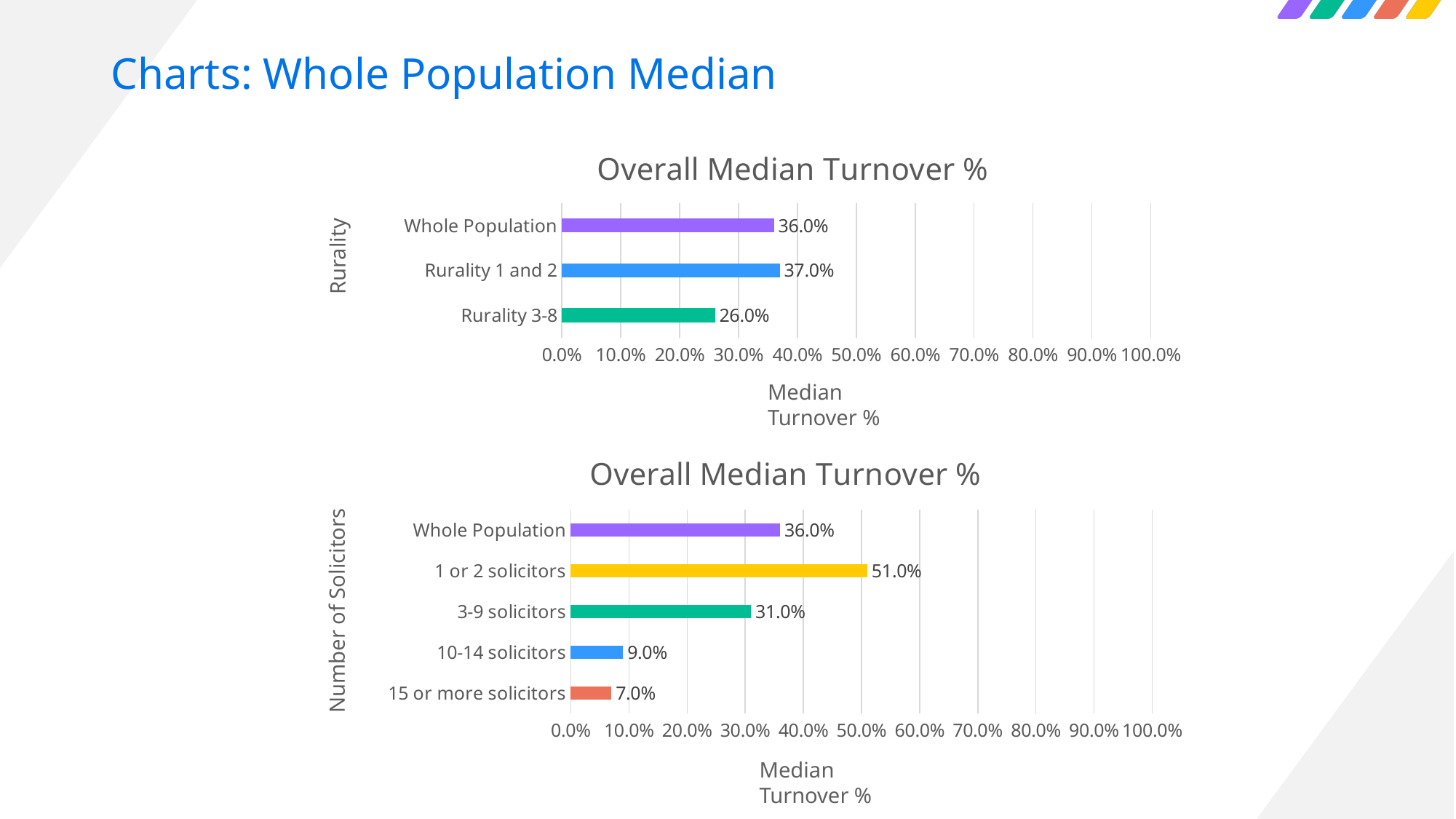
In the bottom chart (Number of Solicitors), which is larger: the value for 3-9 solicitors or the value for 10-14 solicitors? 3-9 solicitors In the top chart (Rurality), how many categories are plotted? 3 What type of chart is the bottom chart (Number of Solicitors)? Bar chart In the bottom chart (Number of Solicitors), what is the difference between the values for 1 or 2 solicitors and Whole Population? 15.0% In the top chart (Rurality), what is the difference between the values for Rurality 1 and 2 and Rurality 3-8? 11.0% In the bottom chart (Number of Solicitors), how many categories are plotted? 5 In the bottom chart (Number of Solicitors), which category has the highest median turnover %? 1 or 2 solicitors In the top chart (Rurality), which category has the lowest median turnover %? Rurality 3-8 In the bottom chart (Number of Solicitors), what is the median turnover % for 1 or 2 solicitors? 51.0% In the top chart (Rurality), what is the median turnover % for Rurality 1 and 2? 37.0% In the bottom chart (Number of Solicitors), what is the median turnover % for 15 or more solicitors? 7.0% In the top chart (Rurality), what is the median turnover % for Rurality 3-8? 26.0%